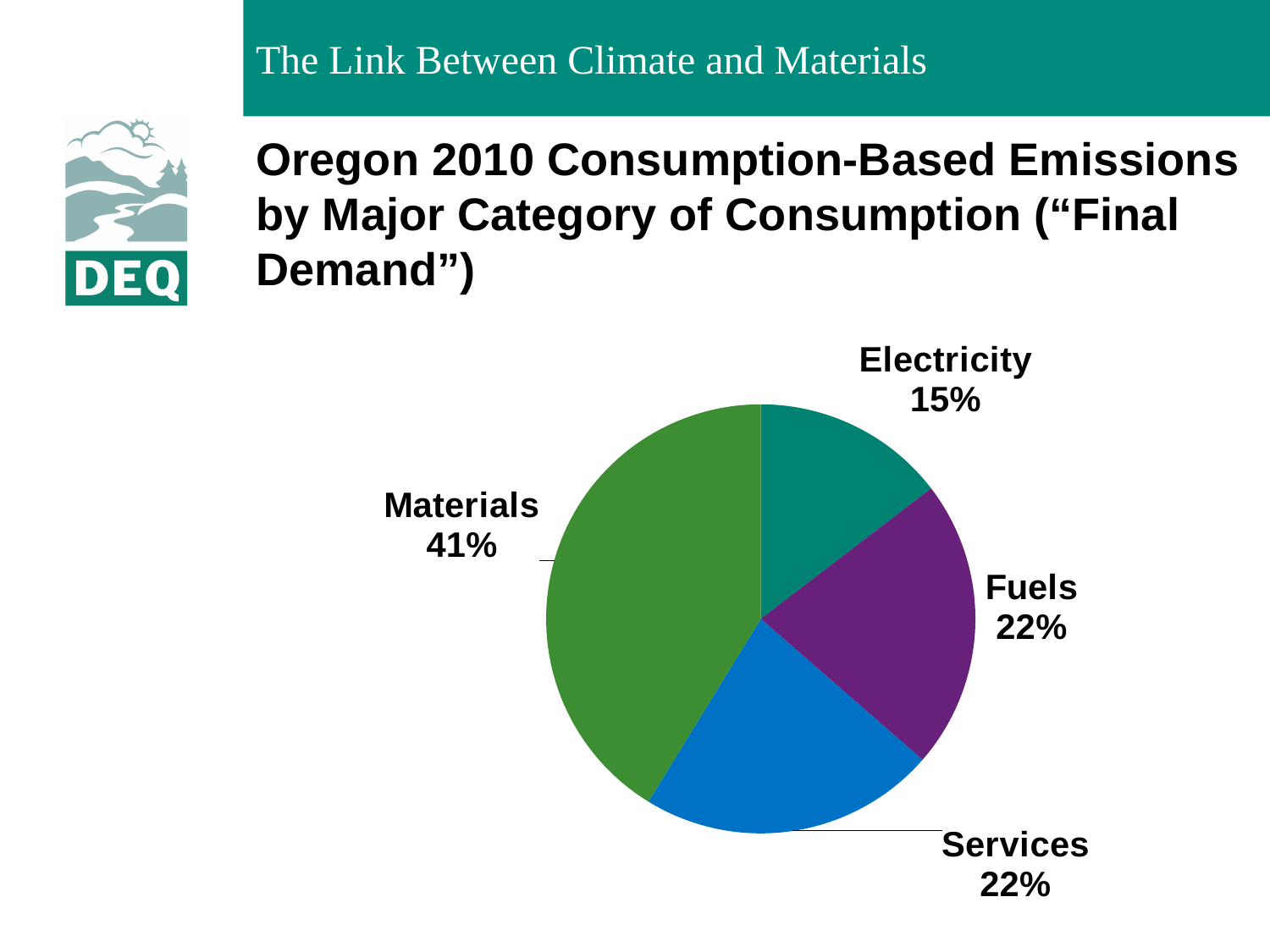
What percentage is shown for Fuels? 22% What kind of chart is shown on the slide? Pie chart Which category accounts for the largest share of emissions? Materials Which is larger, the share for Materials or the share for Fuels? Materials What share of Oregon 2010 consumption-based emissions is attributed to Materials? 41% What share of emissions does the Electricity slice represent? 15% What percentage is shown for Services? 22% Which category accounts for the smallest share of emissions? Electricity How many categories are shown in the pie chart? 4 How many percentage points larger is the Materials share than the Electricity share? 26 What is the combined share of Fuels and Services? 44% What colour is the Materials slice of the pie chart? Green